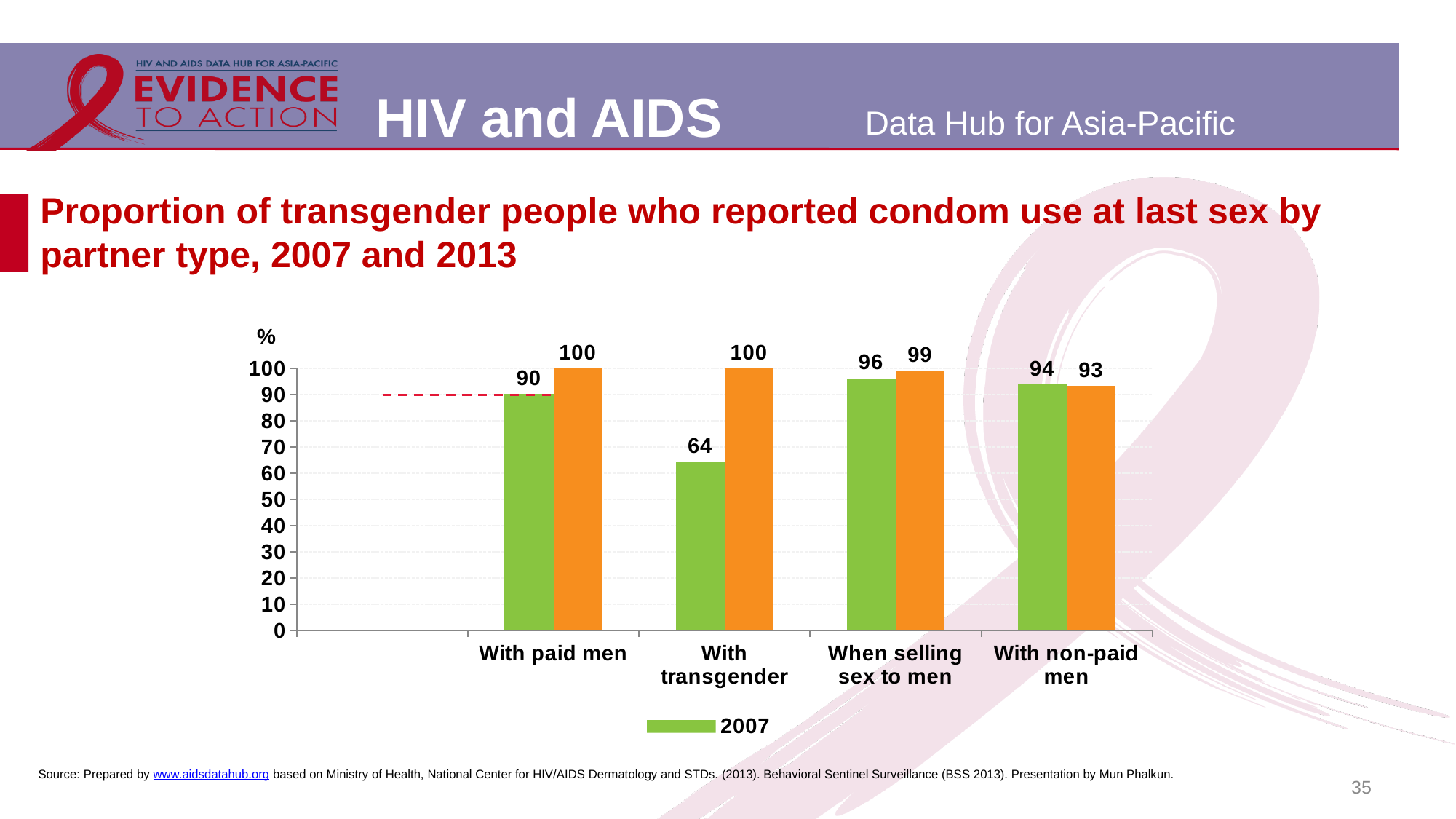
What is the value of the orange bar for 'When selling sex to men'? 99 What is the difference between the orange bar and the 2007 bar for 'With paid men'? 10 Which partner type has the lowest 2007 value? With transgender How many series does the legend list? 1 Which partner type has the highest 2007 value? When selling sex to men What is the value of the orange bar for 'With non-paid men'? 93 For 'With non-paid men', which is larger: the 2007 bar or the orange bar? 2007 bar What is the 2007 value for 'With paid men'? 90 What kind of chart is shown on the slide? Bar chart What is the 2007 value for 'With transgender'? 64 How many partner-type categories are shown on the x axis? 4 What is the difference between the orange bar and the 2007 bar for 'With transgender'? 36